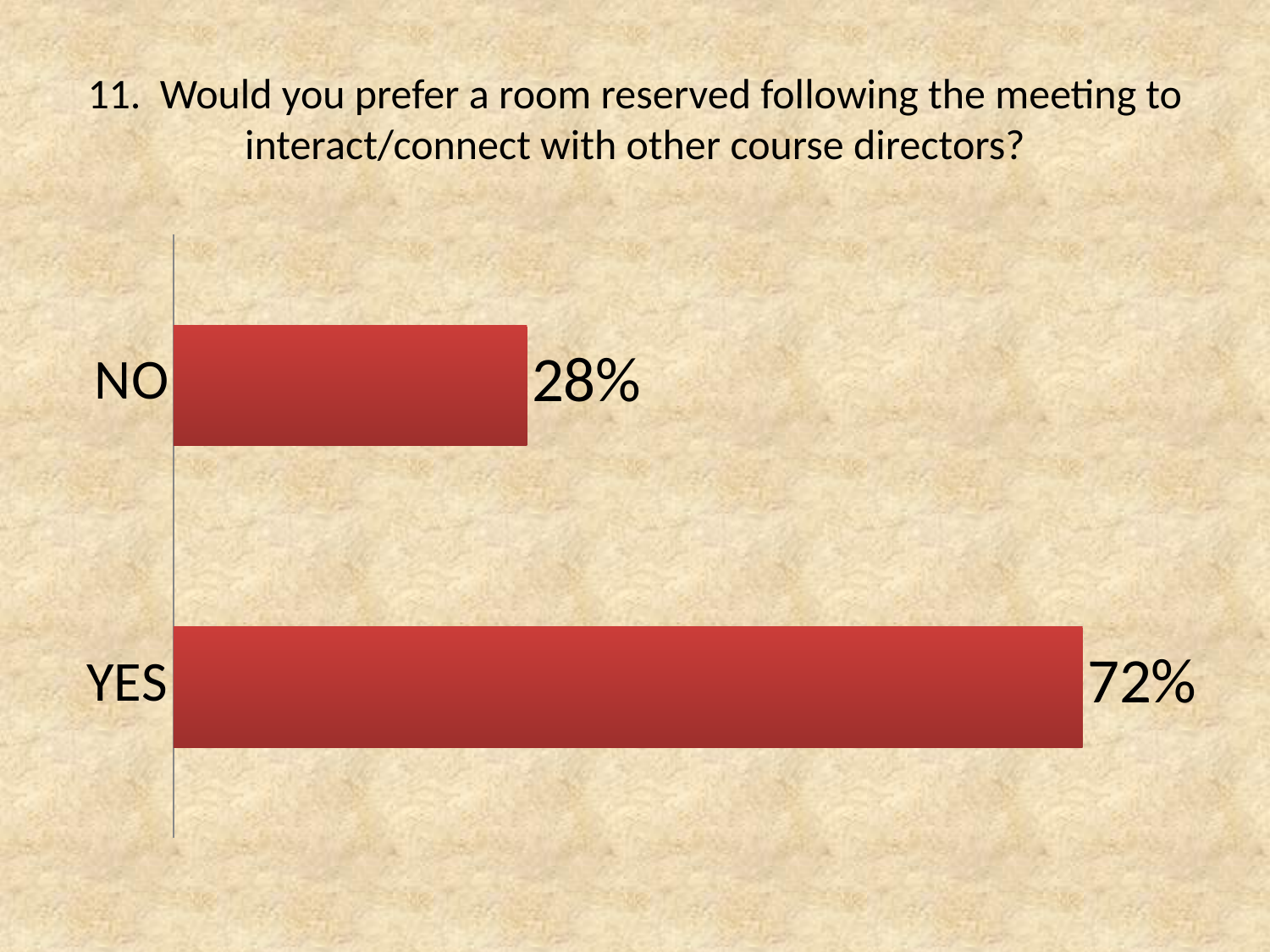
What is the difference between the YES and NO percentages? 44% What is the total of the YES and NO percentages? 100% How many response categories are shown in the chart? 2 What kind of chart is shown on the slide? Bar chart What percentage of respondents answered NO? 28% Which response has the lowest value? NO What percentage of respondents answered YES? 72% What question number is shown in the slide title? 11 What colour are the bars in the chart? Red Which is larger, the value for YES or the value for NO? YES Which response has the highest value? YES